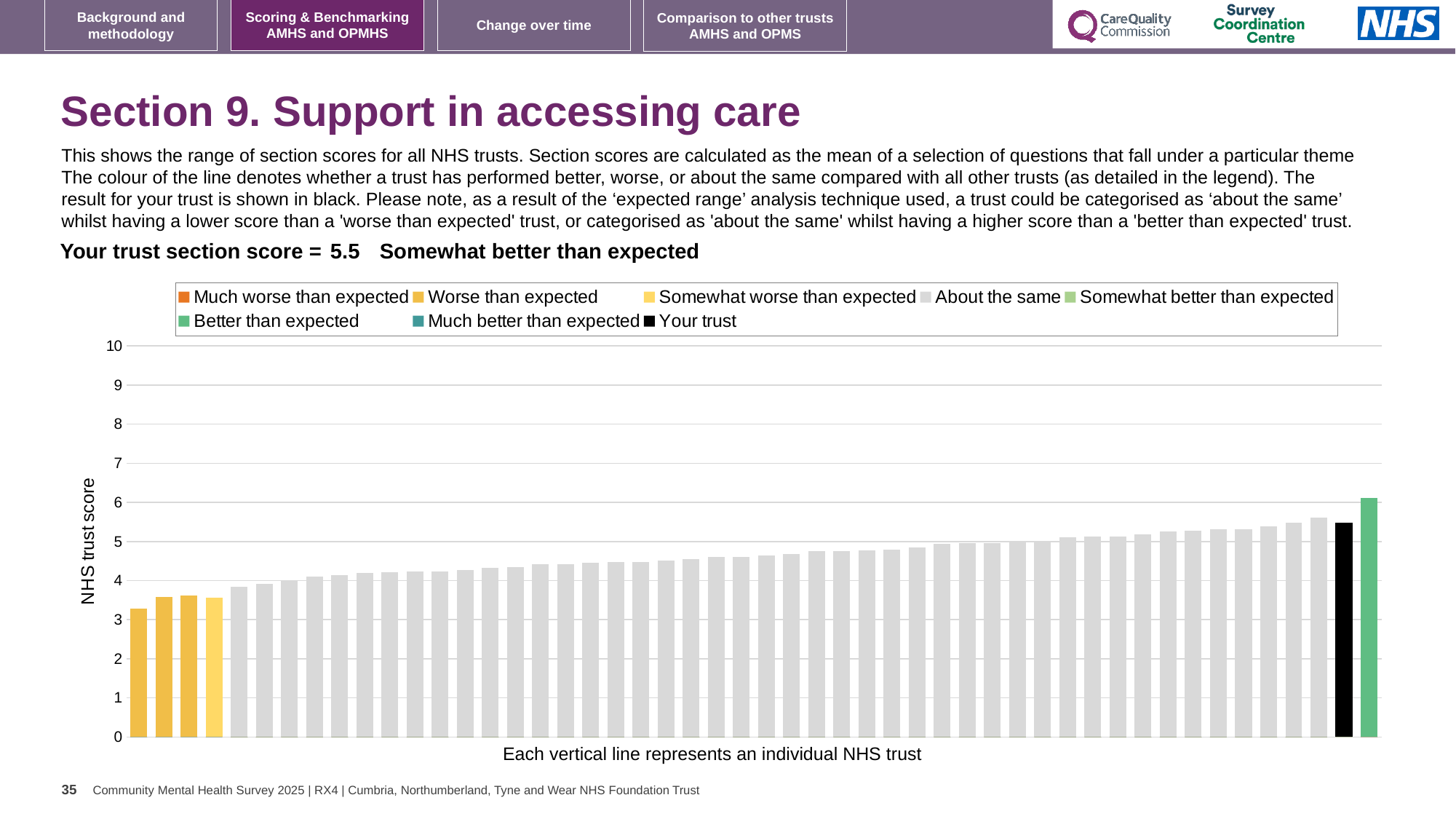
What kind of chart is shown on the slide? bar chart Is the leftmost bar or the black bar (your trust) larger? the black bar What is the label on the vertical axis of the chart? NHS trust score What is the section score for your trust, as stated on the slide? 5.5 Is the value of the rightmost (green) bar greater or less than 5? greater Which bar is the highest in the chart: the black bar or the green bar at the far right? the green bar How many bars at the left of the chart are coloured yellow rather than grey? 4 Is the value of the black bar (your trust) greater or less than 5? greater Do the bar values rise or fall from left to right along the x axis? rise How many entries does the chart legend list? 8 Is the value of the leftmost bar greater or less than 4? less Which category does your trust fall into for this section, according to the slide? Somewhat better than expected